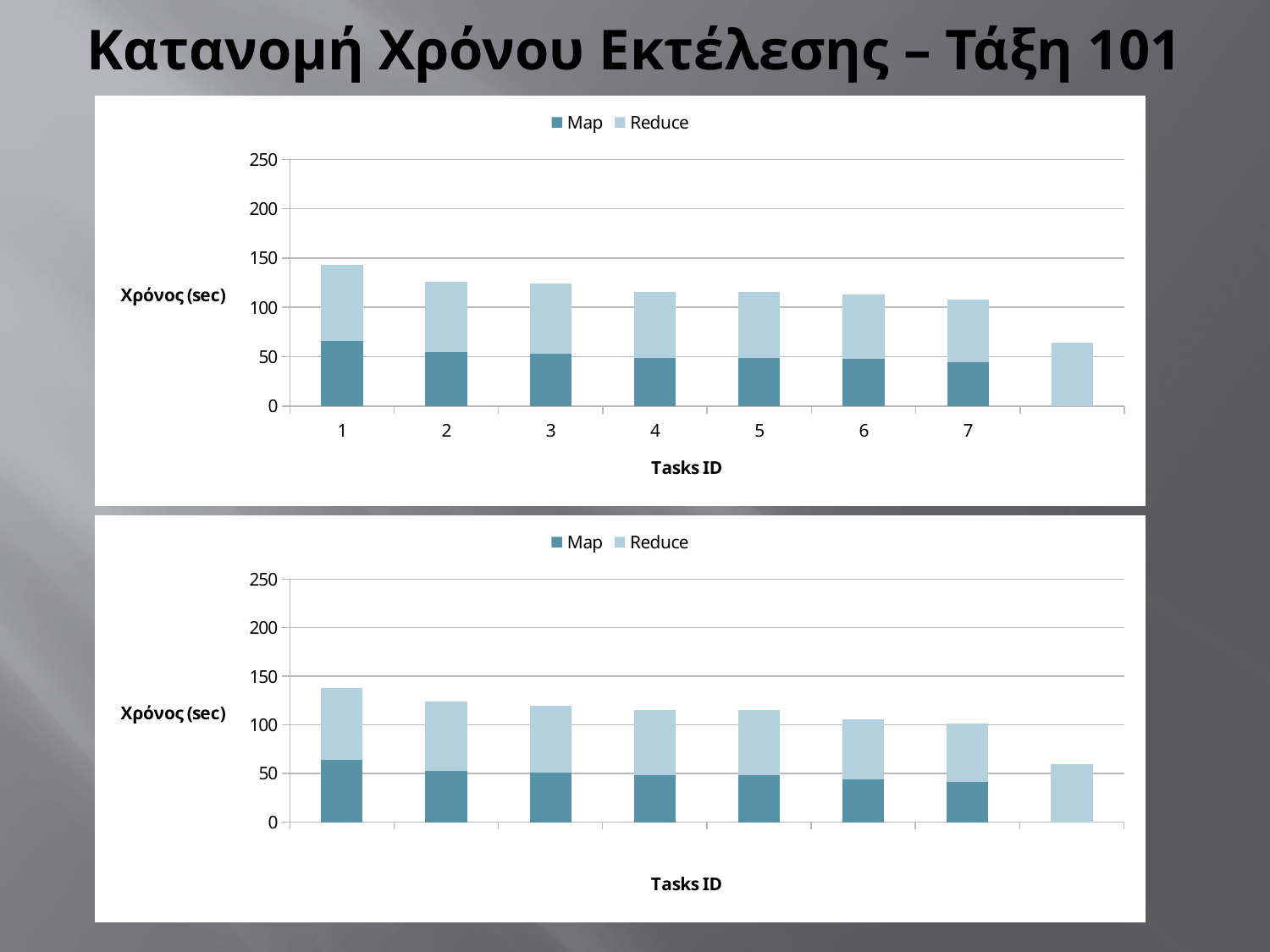
In the top chart, is the Map value for Task ID 1 greater or less than 50? greater What are the two series named in the legend of the bottom chart? Map and Reduce In the top chart, which total bar is larger, Task ID 1 or Task ID 7? Task ID 1 What is the y-axis title of the bottom chart? Χρόνος (sec) How many series does the legend of the top chart list? 2 In the top chart, which labelled Task ID has the highest total bar? 1 In the bottom chart, is the total value of the leftmost bar greater or less than 100? greater In the top chart, is the total value for Task ID 7 greater or less than 150? less How many bars are plotted in the top chart? 8 What kind of chart is the top chart on the slide? stacked bar chart In the top chart, do the total bar heights rise or fall from Task ID 1 to Task ID 7? fall